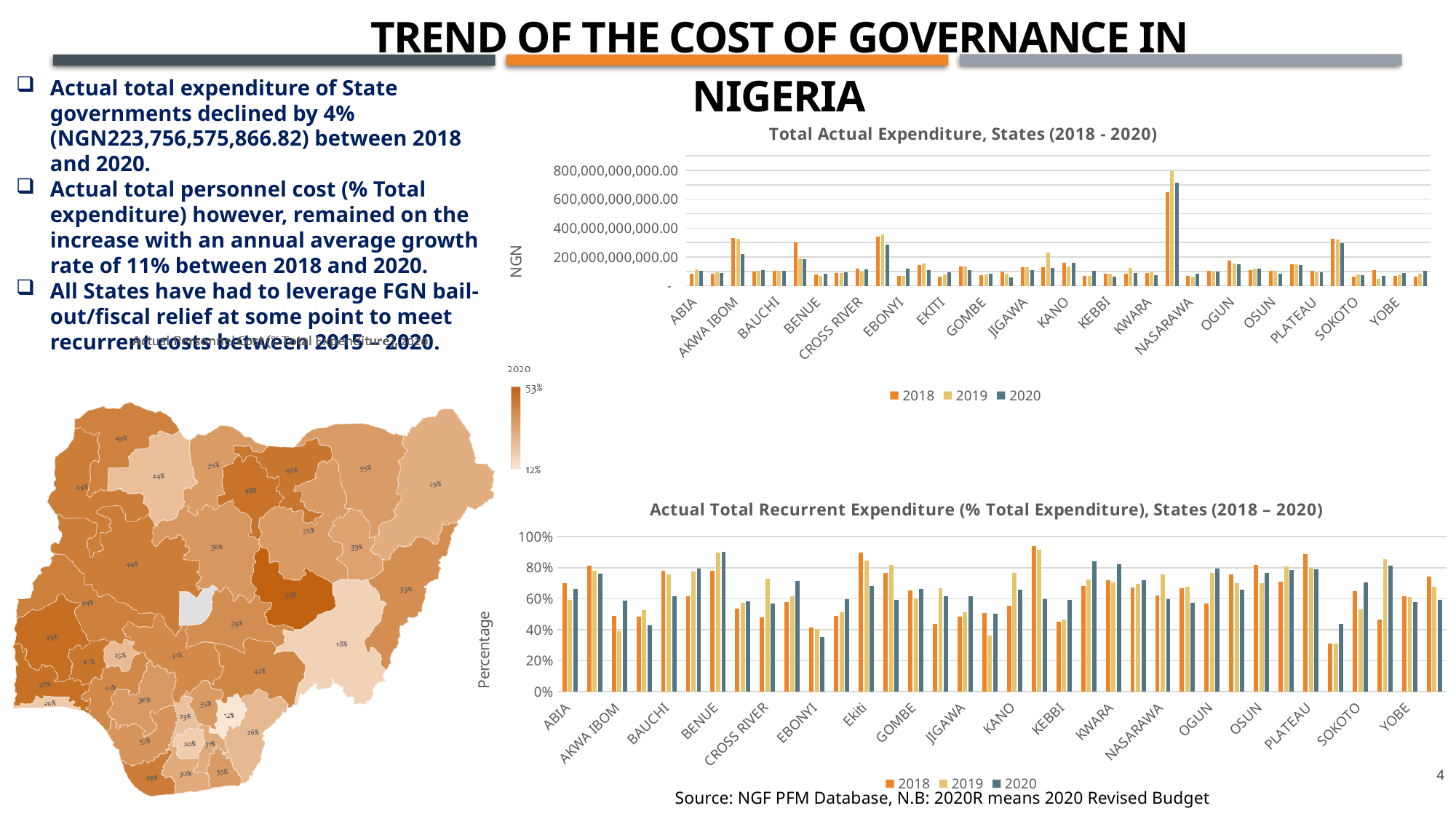
How many series does the legend of the top chart 'Total Actual Expenditure, States (2018 - 2020)' list? 3 In the bottom chart 'Actual Total Recurrent Expenditure (% Total Expenditure), States (2018 – 2020)', what is the label on the vertical axis? Percentage On the map of Nigeria at the bottom left, what is the lowest percentage shown on the colour scale? 12% How many series does the legend of the bottom chart 'Actual Total Recurrent Expenditure (% Total Expenditure), States (2018 – 2020)' list? 3 What kind of chart is the top chart titled 'Total Actual Expenditure, States (2018 - 2020)'? bar chart In the top chart 'Total Actual Expenditure, States (2018 - 2020)', what is the label on the vertical axis? NGN In the top chart 'Total Actual Expenditure, States (2018 - 2020)', what is the highest value shown on the vertical axis? 800,000,000,000.00 What kind of chart is the bottom chart titled 'Actual Total Recurrent Expenditure (% Total Expenditure), States (2018 – 2020)'? bar chart On the map of Nigeria at the bottom left, what is the highest percentage shown on the colour scale? 53%